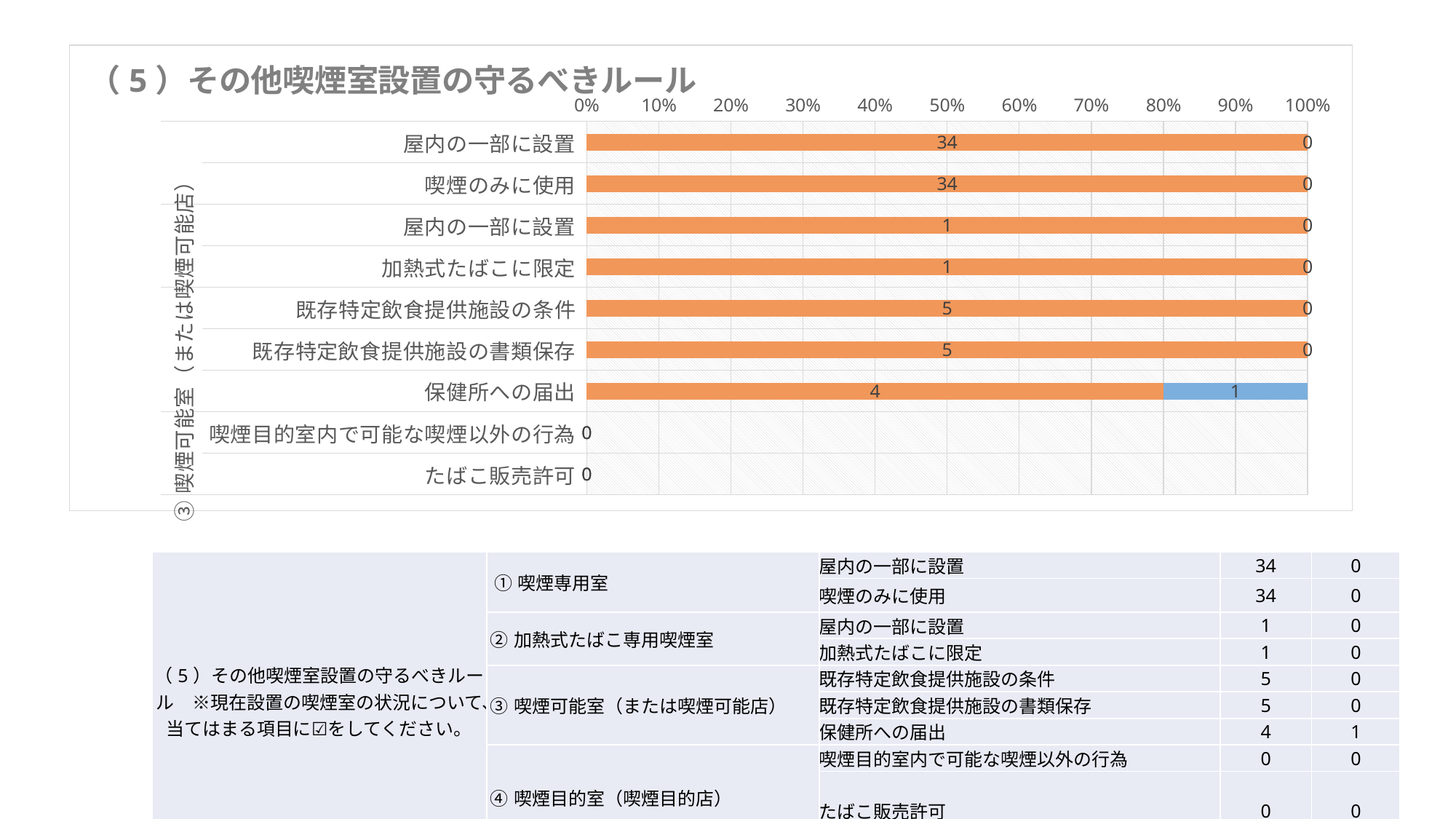
Is the orange bar for 保健所への届出 greater or less than 70% on the horizontal axis? greater What kind of chart is shown on the slide? bar chart What value is shown for たばこ販売許可? 0 What is the value labelled on the blue bar for 保健所への届出? 1 What is the value labelled on the orange bar for 既存特定飲食提供施設の書類保存? 5 What is the total of the two labelled values in the bar for 保健所への届出? 5 What is the value labelled on the orange bar for 喫煙のみに使用? 34 What is the value labelled on the orange bar for 加熱式たばこに限定? 1 Which has the larger orange value: 既存特定飲食提供施設の条件 or 加熱式たばこに限定? 既存特定飲食提供施設の条件 How many categories are listed on the vertical axis of the chart? 9 What is the title of the chart? （５）その他喫煙室設置の守るべきルール What is the difference between the orange value for 喫煙のみに使用 and the orange value for 既存特定飲食提供施設の条件? 29